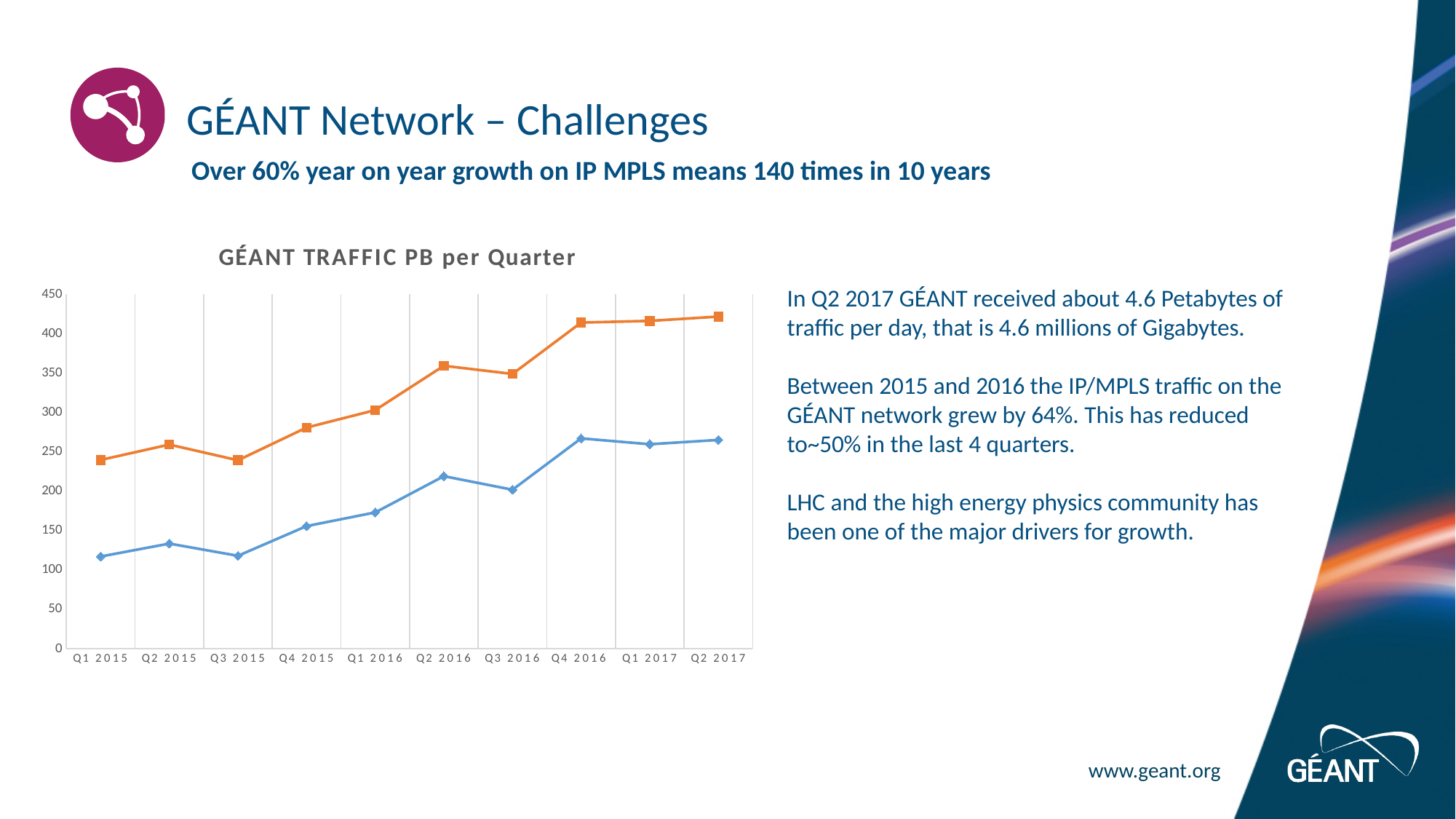
Which line has the higher value in Q2 2016, the orange line or the blue line? The orange line Is the value of the orange line for Q4 2016 greater or less than 400? greater Overall, do the values of the orange line rise or fall from Q1 2015 to Q2 2017? Rise Is the value of the orange line for Q1 2015 greater or less than 250? less For the blue line, which quarter has the higher value, Q2 2016 or Q3 2016? Q2 2016 How many quarters are plotted along the x axis of the chart? 10 What is the title of the chart? GÉANT TRAFFIC PB per Quarter Is the value of the orange line for Q2 2017 greater or less than 400? greater How many lines (series) are plotted in the chart? 2 What type of chart is shown on the slide? Line chart